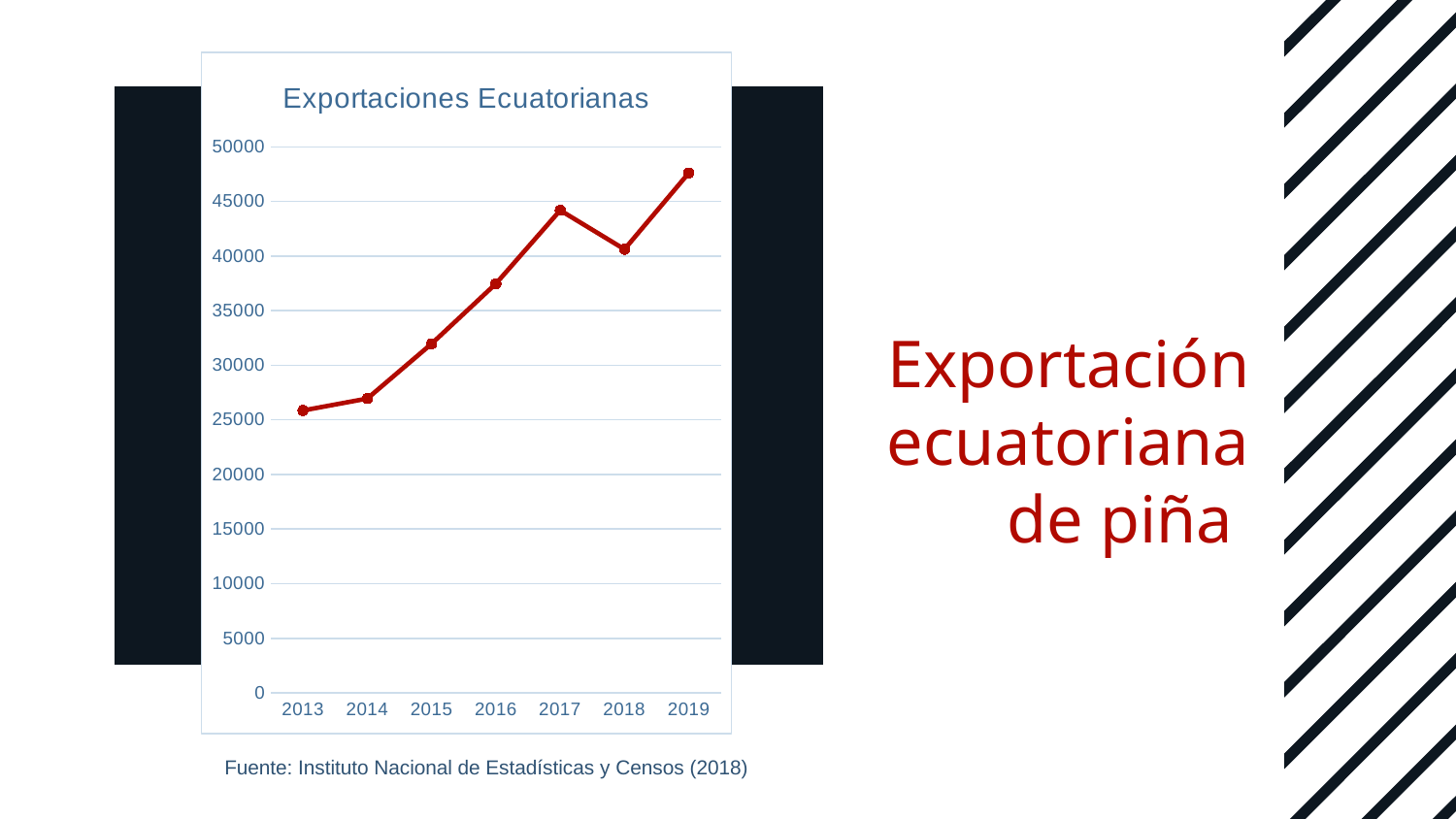
Which year has the larger value, 2017 or 2018? 2017 Is the value for 2013 greater or less than 30000? less What kind of chart is shown on the slide? line chart Is the value for 2019 greater or less than 45000? greater Is the value for 2016 greater or less than 35000? greater Which year has the lowest value in the chart? 2013 What is the title of the chart? Exportaciones Ecuatorianas How many years are plotted on the x axis of the chart? 7 Do the values generally rise or fall from 2013 to 2017? rise What source is cited below the chart? Instituto Nacional de Estadísticas y Censos (2018) Which year has the highest value in the chart? 2019